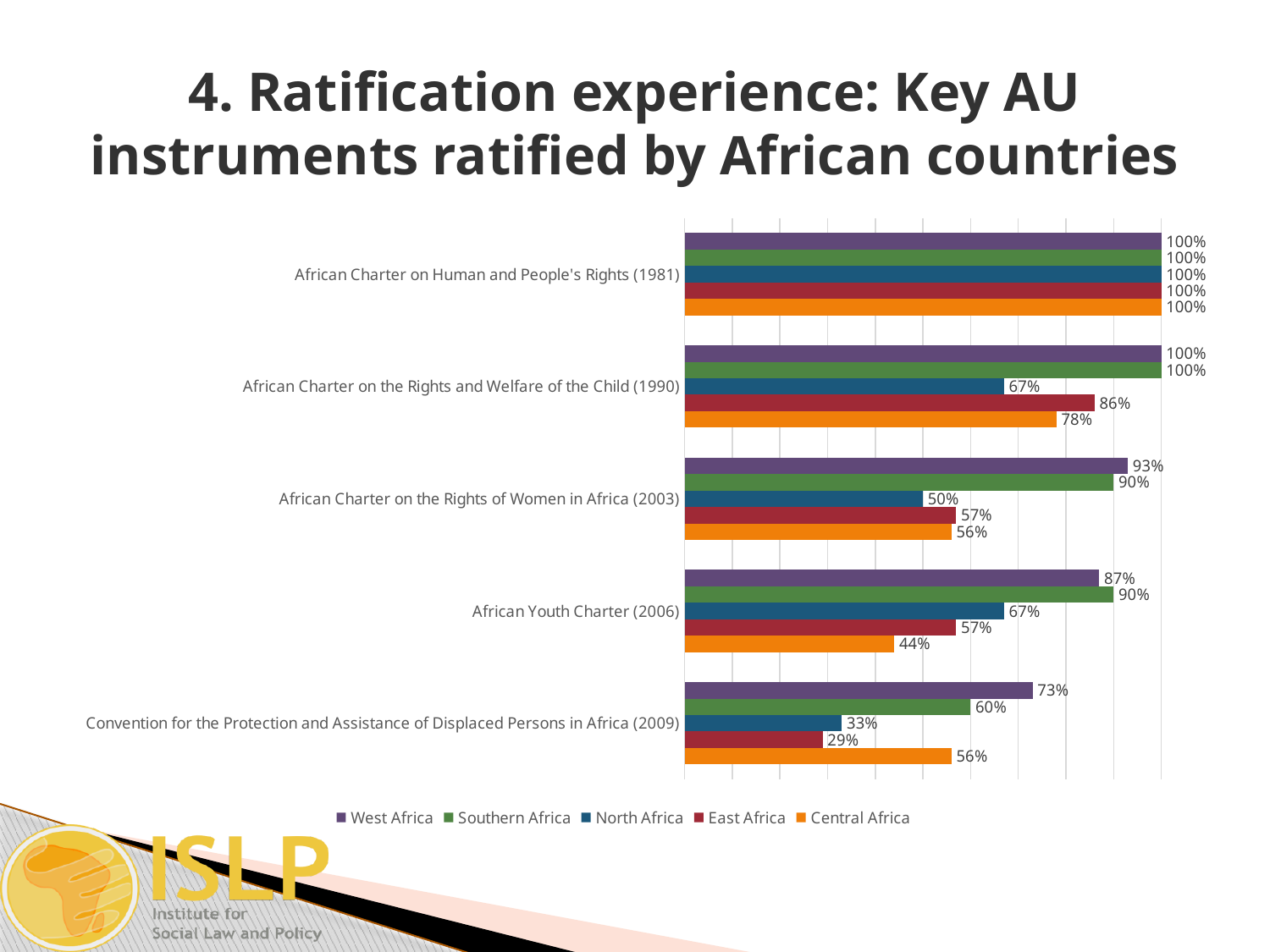
What is the difference between the West Africa and Southern Africa values for the Convention for the Protection and Assistance of Displaced Persons in Africa (2009)? 13% What type of chart is shown on the slide? bar chart For the African Youth Charter (2006), which is larger: the value for North Africa or the value for East Africa? North Africa What is the value for East Africa for the Convention for the Protection and Assistance of Displaced Persons in Africa (2009)? 29% Which region has the highest value for the Convention for the Protection and Assistance of Displaced Persons in Africa (2009)? West Africa What is the value for North Africa for the African Charter on the Rights and Welfare of the Child (1990)? 67% Which series is shown in orange in the legend? Central Africa How many AU instruments (categories) are shown on the chart? 5 What is the value for Central Africa for the African Youth Charter (2006)? 44% How many series does the legend list? 5 Which region has the lowest value for the African Charter on the Rights of Women in Africa (2003)? North Africa What is the difference between the East Africa and Central Africa values for the African Charter on the Rights and Welfare of the Child (1990)? 8%